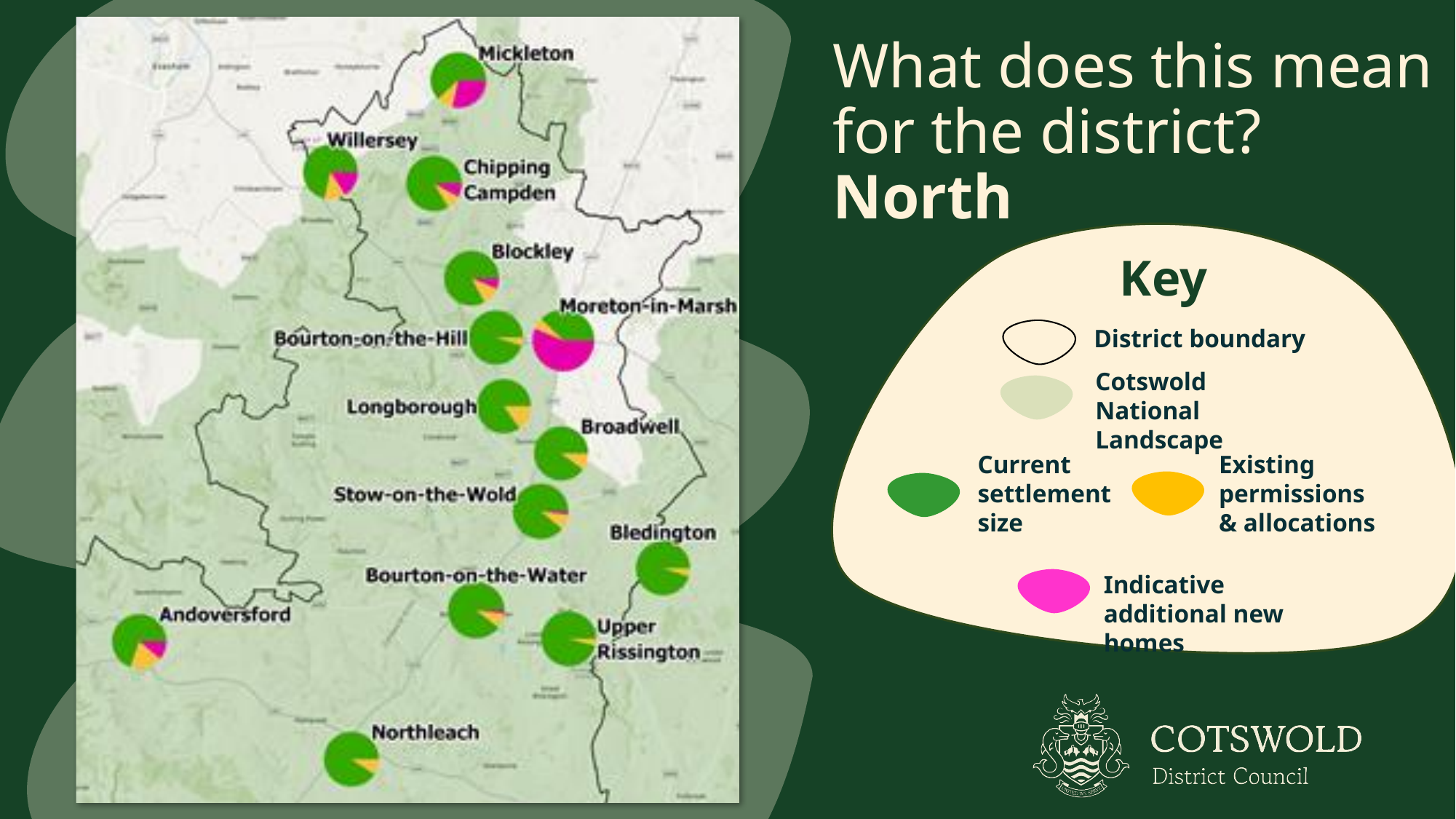
According to the key, what does the pink slice of each pie represent? Indicative additional new homes Which has a larger pink share of its pie chart: Mickleton or Northleach? Mickleton Which settlement's pie chart has the largest pink (indicative additional new homes) share? Moreton-in-Marsh What kind of chart is used on the map to show each settlement? Pie chart Which settlement has the largest pie chart overall on the map? Moreton-in-Marsh In the Bledington pie chart, which colour takes up the largest share? Green How many settlements on the map have a pie chart? 14 In the Moreton-in-Marsh pie chart, which is larger: the pink slice or the yellow slice? Pink What is the title of the slide containing the map of pie charts? What does this mean for the district? North How many categories does each pie chart divide into according to the key? 3